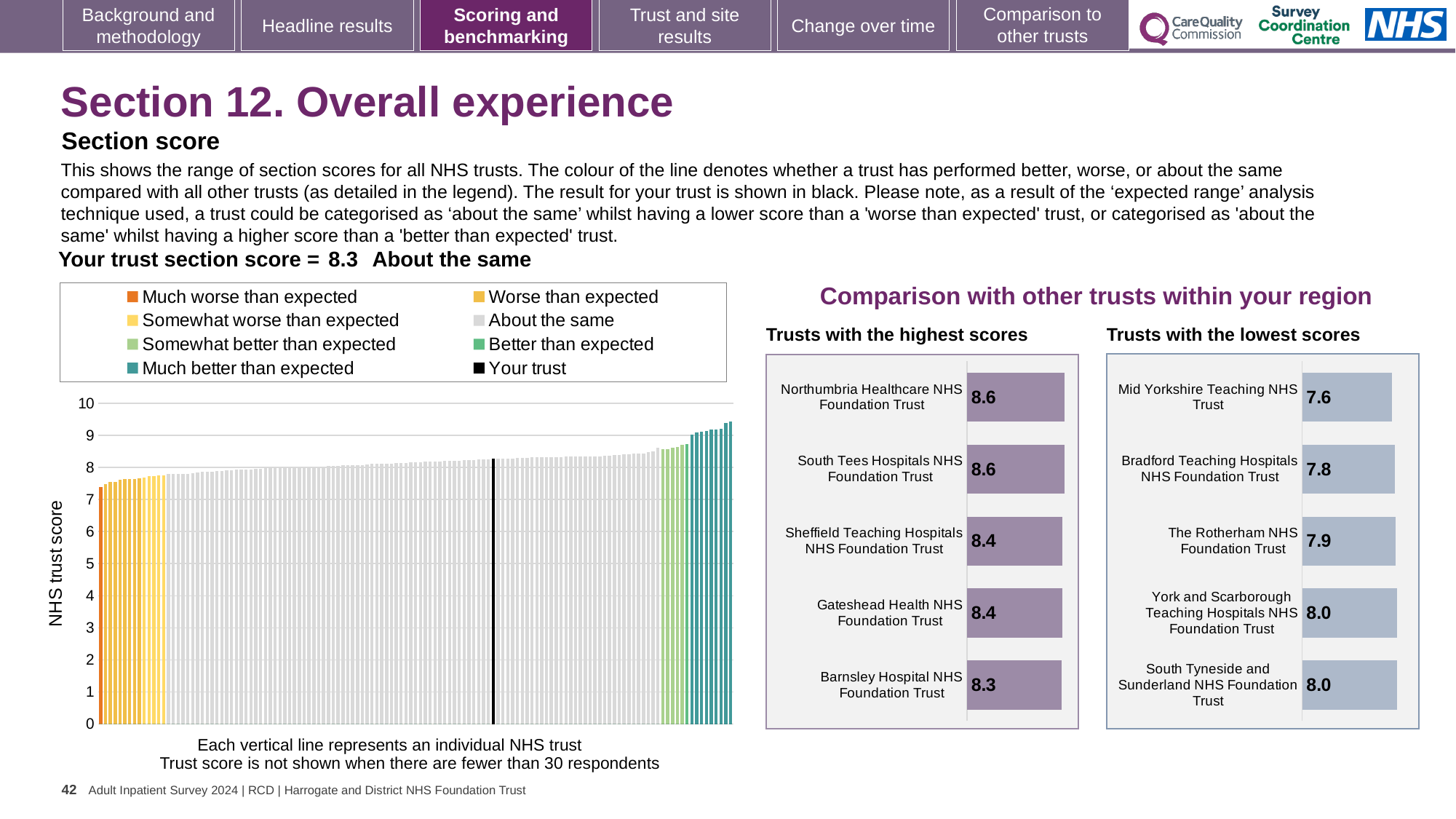
In the 'Trusts with the highest scores' chart, what is the score for Sheffield Teaching Hospitals NHS Foundation Trust? 8.4 How many entries does the legend of the main chart of all NHS trusts list? 8 What kind of chart is the 'Trusts with the lowest scores' chart? Bar chart In the 'Trusts with the lowest scores' chart, what is the difference between the scores of The Rotherham NHS Foundation Trust and Mid Yorkshire Teaching NHS Trust? 0.3 In the 'Trusts with the lowest scores' chart, which trust has the lowest score? Mid Yorkshire Teaching NHS Trust In the 'Trusts with the highest scores' chart, what is the difference between the scores of Northumbria Healthcare NHS Foundation Trust and Barnsley Hospital NHS Foundation Trust? 0.3 In the 'Trusts with the highest scores' chart, which has the higher score: Gateshead Health NHS Foundation Trust or Barnsley Hospital NHS Foundation Trust? Gateshead Health NHS Foundation Trust In the 'Trusts with the lowest scores' chart, what is the score for Mid Yorkshire Teaching NHS Trust? 7.6 In the 'Trusts with the highest scores' chart, what is the score for Northumbria Healthcare NHS Foundation Trust? 8.6 In the main chart of all NHS trusts, is the value for 'Your trust' greater or less than 8? greater How many trusts are shown in the 'Trusts with the highest scores' chart? 5 In the 'Trusts with the lowest scores' chart, what is the score for Bradford Teaching Hospitals NHS Foundation Trust? 7.8